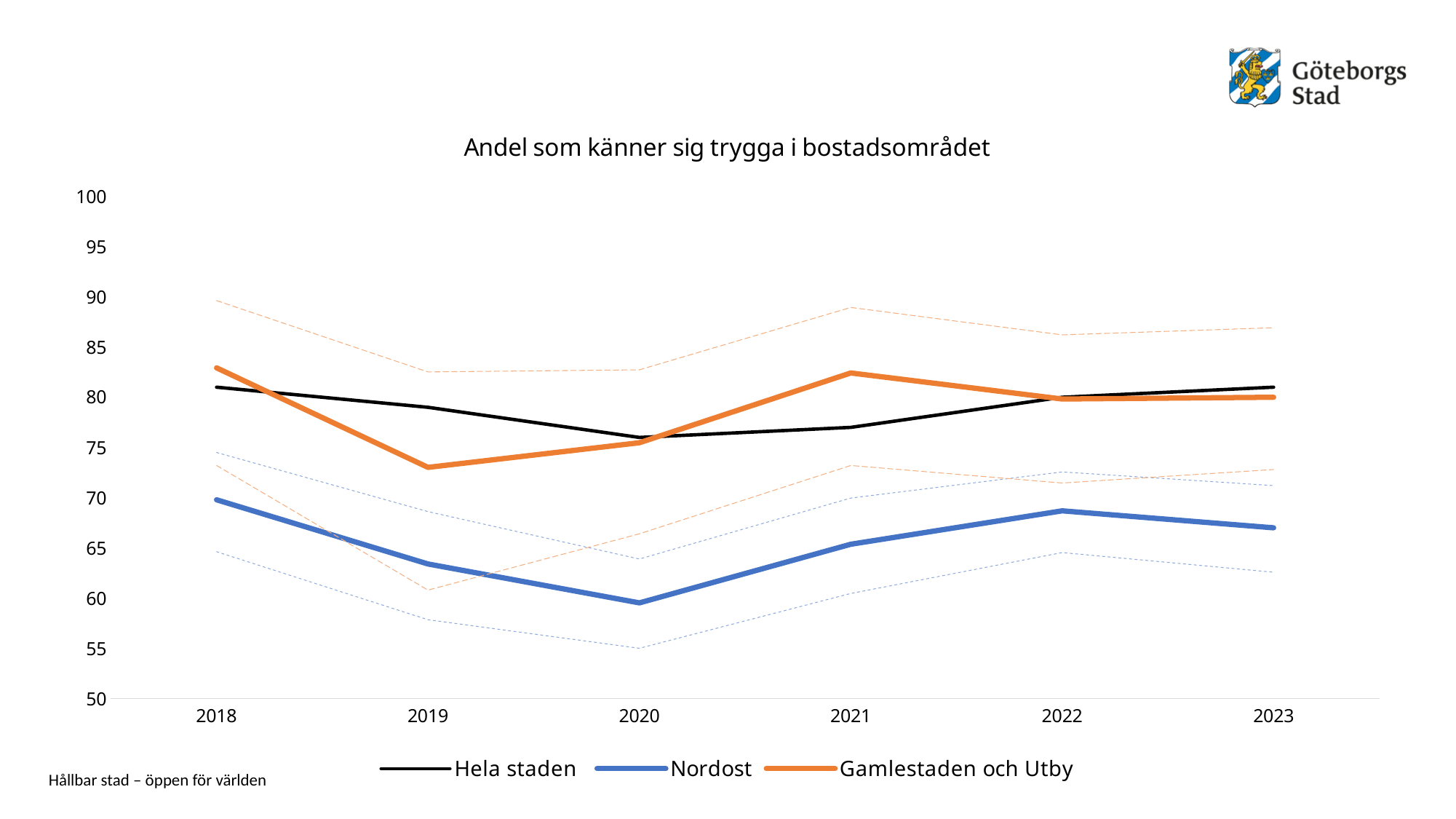
In which year is the value for Nordost lowest? 2020 Does the value for Nordost rise or fall from 2018 to 2020? Fall What kind of chart is shown on the slide? Line chart Is the value for Hela staden in 2020 greater or less than 75? greater How many series does the legend list? 3 In 2021, which is higher: Gamlestaden och Utby or Hela staden? Gamlestaden och Utby Is the value for Gamlestaden och Utby in 2018 greater or less than 80? greater How many years are shown on the x axis? 6 In 2019, which is higher: Hela staden or Gamlestaden och Utby? Hela staden Is the value for Nordost in 2020 greater or less than 65? less In which year is the value for Gamlestaden och Utby lowest? 2019 What is the title of the chart? Andel som känner sig trygga i bostadsområdet